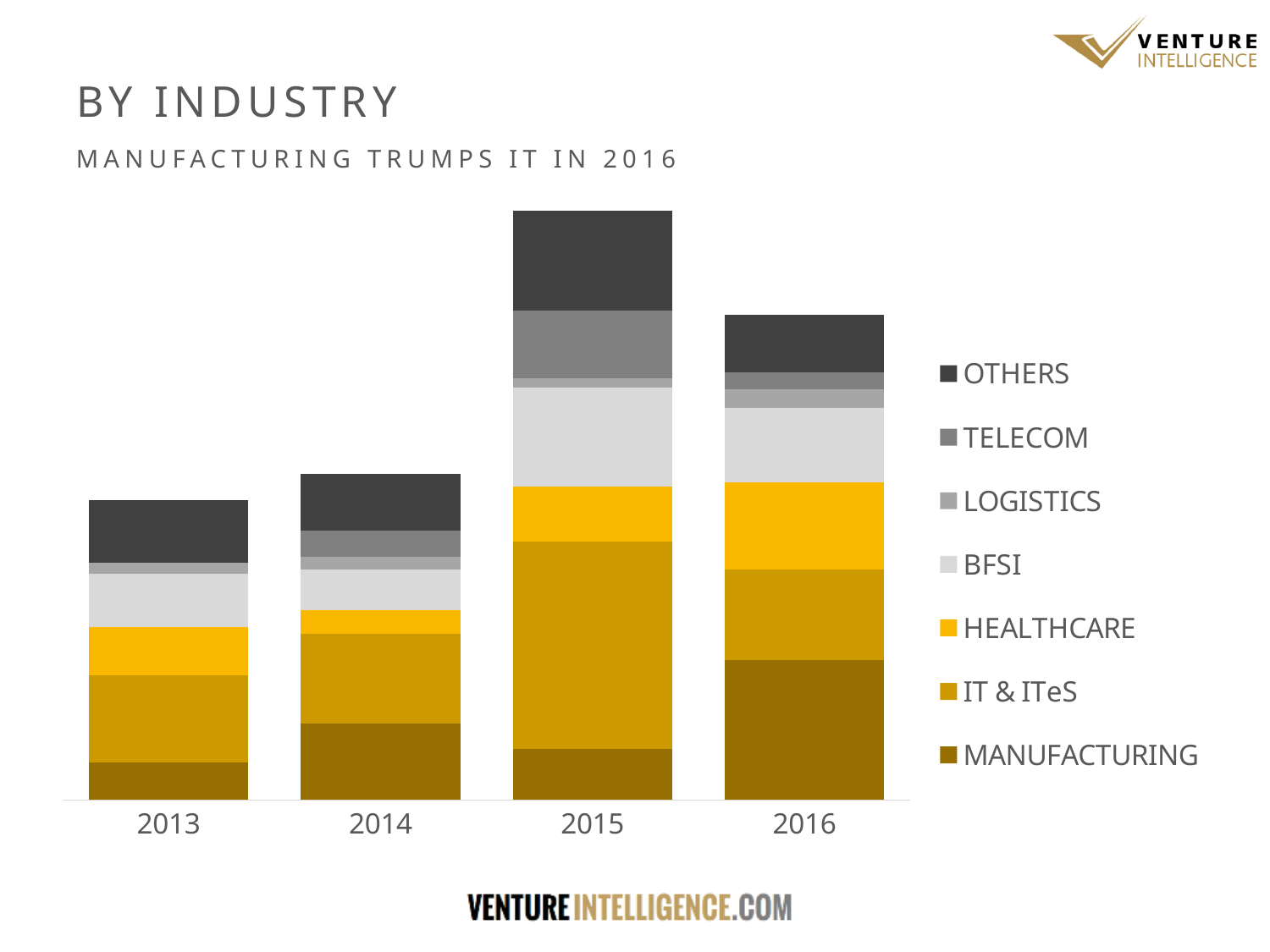
Do the total bar heights rise or fall from 2013 to 2015? Rise What kind of chart is shown on the slide? Stacked bar chart Which year has the larger MANUFACTURING segment, 2013 or 2016? 2016 What is the subtitle of the chart slide? MANUFACTURING TRUMPS IT IN 2016 Which year has the larger total bar, 2015 or 2016? 2015 Which series is shown at the bottom of each stacked bar? MANUFACTURING In 2015, which segment is larger, IT & ITeS or MANUFACTURING? IT & ITeS How many series does the chart's legend list? 7 Which year has the shortest stacked bar overall? 2013 Which year has the tallest stacked bar overall? 2015 How many years are shown on the x axis of the chart? 4